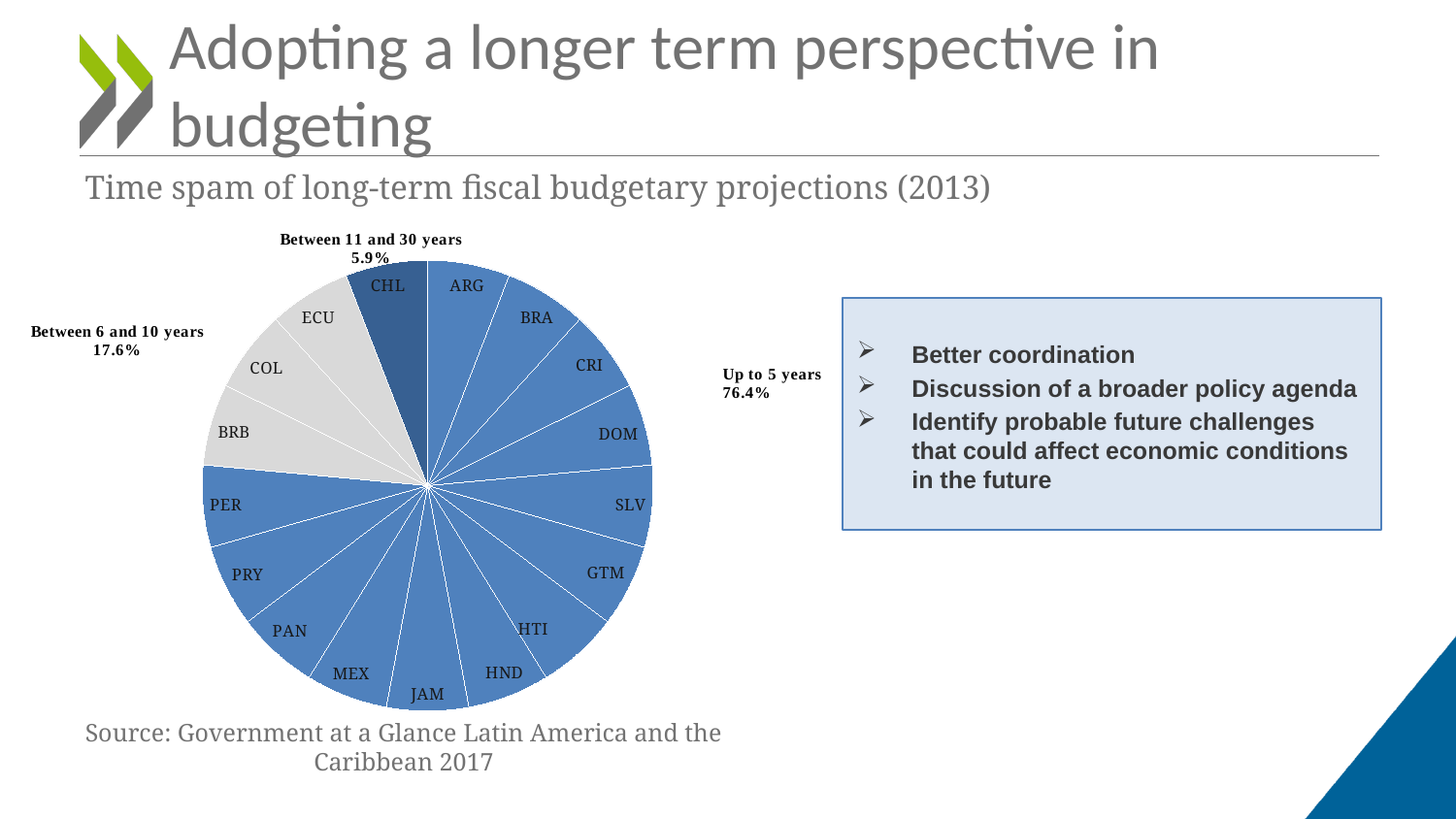
What share of the pie is labelled "Between 11 and 30 years"? 5.9% Which is larger, the share for "Between 6 and 10 years" or the share for "Between 11 and 30 years"? Between 6 and 10 years Which country is the only one in the "Between 11 and 30 years" group? CHL Which time-span group has the largest share of the pie? Up to 5 years Which countries are in the "Between 6 and 10 years" group? BRB, COL, ECU What is the title of the chart? Time spam of long-term fiscal budgetary projections (2013) What share of the pie is labelled "Up to 5 years"? 76.4% Which time-span group has the smallest share of the pie? Between 11 and 30 years What share of the pie is labelled "Between 6 and 10 years"? 17.6% What kind of chart is shown on the slide? pie chart How many country slices are shown in the pie chart? 17 What is the difference in percentage points between the "Up to 5 years" share and the "Between 6 and 10 years" share? 58.8